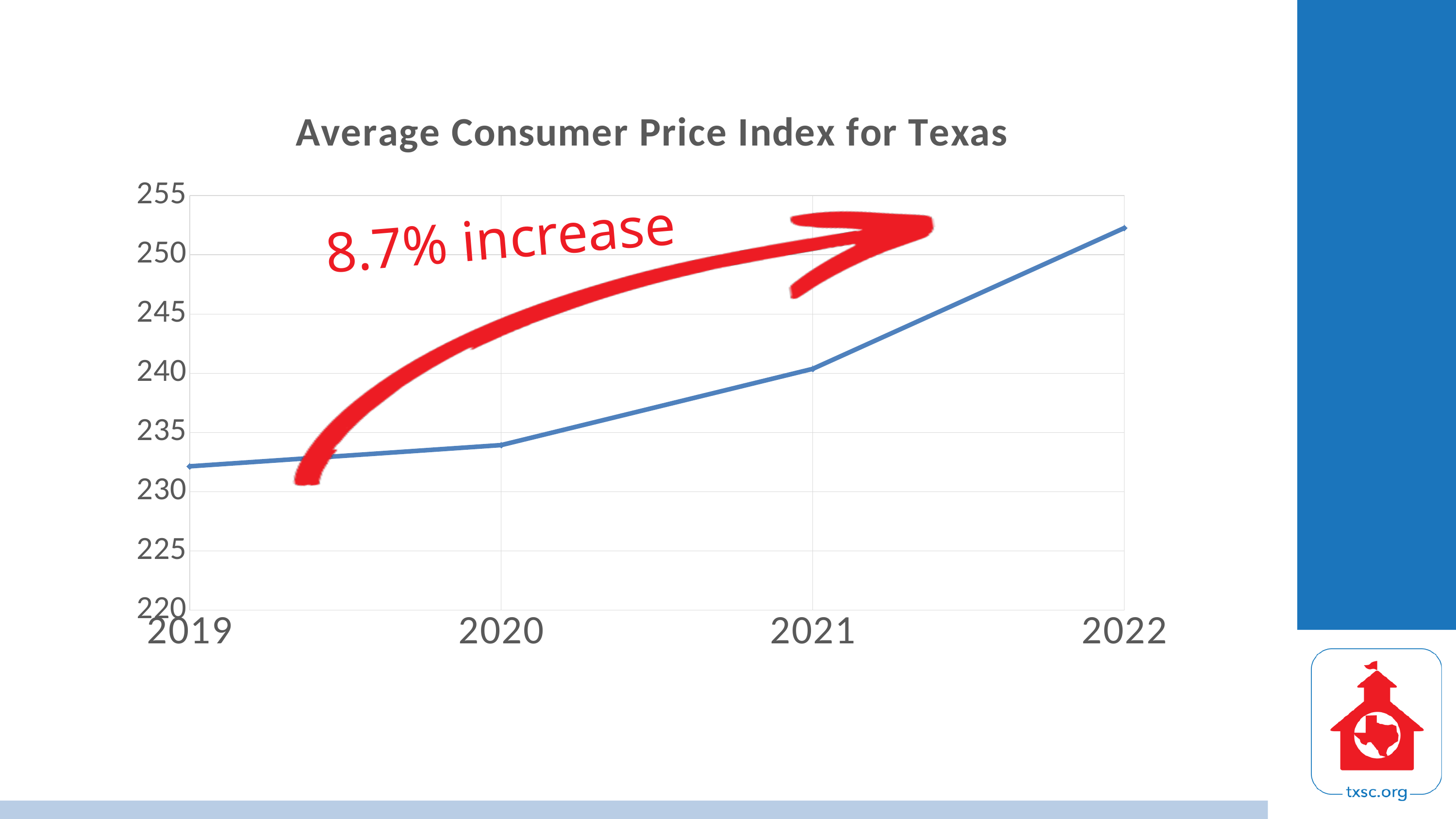
What percentage increase does the red annotation on the chart state? 8.7% increase Is the value for 2020 greater or less than 235? less What kind of chart is shown on the slide? line chart Is the value for 2022 greater or less than 250? greater How many years are plotted on the x axis? 4 Which year has the highest value? 2022 Is the value for 2021 greater or less than 245? less Do the values rise or fall from 2019 to 2022? rise Which year has the lowest value? 2019 What is the title of the chart? Average Consumer Price Index for Texas Which is larger, the value for 2021 or the value for 2020? 2021